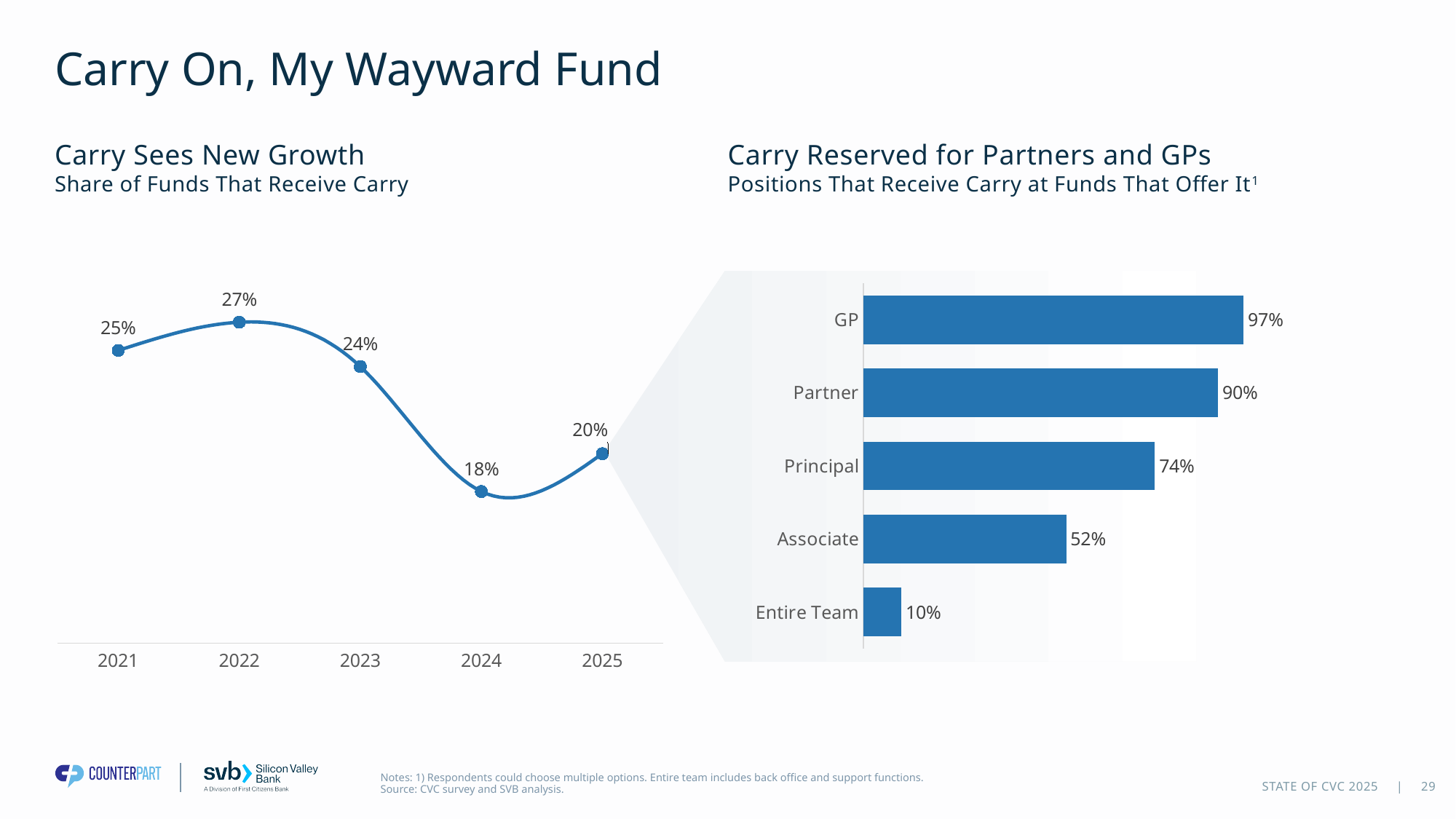
In the 'Carry Sees New Growth' chart, what is the share of funds that receive carry in 2022? 27% In the 'Carry Sees New Growth' chart, how many years are plotted? 5 In the 'Carry Sees New Growth' chart, which year has the highest share of funds that receive carry? 2022 In the 'Carry Sees New Growth' chart, does the value rise or fall from 2023 to 2024? Fall In the 'Carry Reserved for Partners and GPs' chart, which position has the lowest value? Entire Team In the 'Carry Sees New Growth' chart, what is the value for 2024? 18% In the 'Carry Reserved for Partners and GPs' chart, what is the difference between the GP and Associate values? 45% What kind of chart is 'Carry Reserved for Partners and GPs'? Bar chart In the 'Carry Reserved for Partners and GPs' chart, what percentage is shown for Principal? 74% What kind of chart is 'Carry Sees New Growth'? Line chart In the 'Carry Sees New Growth' chart, what is the difference between the 2021 and 2025 values? 5% In the 'Carry Sees New Growth' chart, which year has the lowest value? 2024